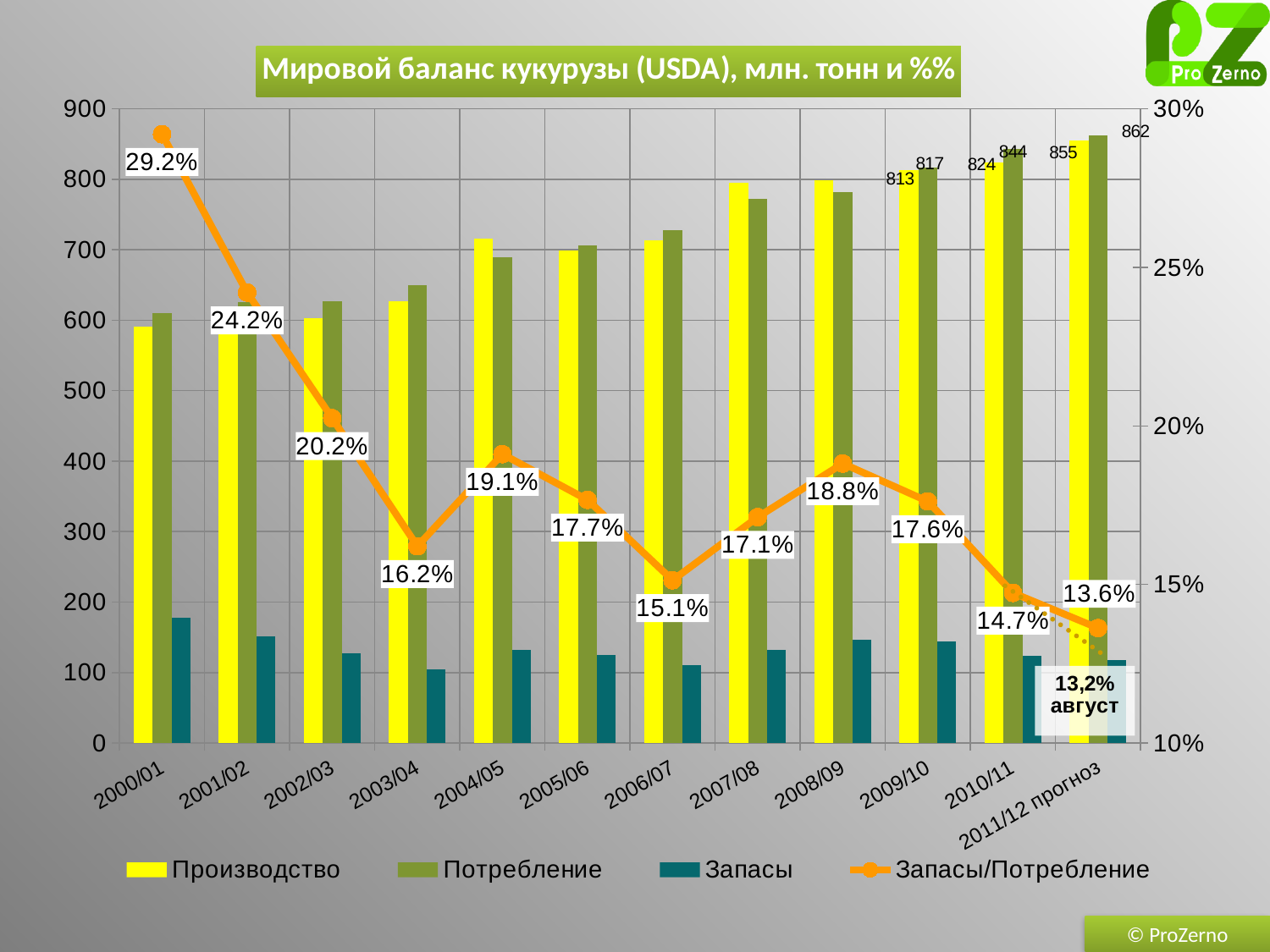
By how much does Потребление exceed Производство in 2011/12 прогноз? 7 What is the Потребление value for 2010/11? 844 How many series does the legend list? 4 What is the difference between Потребление and Производство in 2010/11? 20 Is the Потребление value for 2006/07 greater or less than 700? greater Does the Запасы/Потребление ratio rise or fall from 2000/01 to 2003/04? fall What is the Производство value for 2011/12 прогноз? 855 In 2009/10, which is larger: Производство or Потребление? Потребление What is the Запасы/Потребление value for 2000/01? 29.2% In which season is the Запасы/Потребление ratio lowest? 2011/12 прогноз How many seasons are shown on the x axis? 12 In which season is the Запасы/Потребление ratio highest? 2000/01